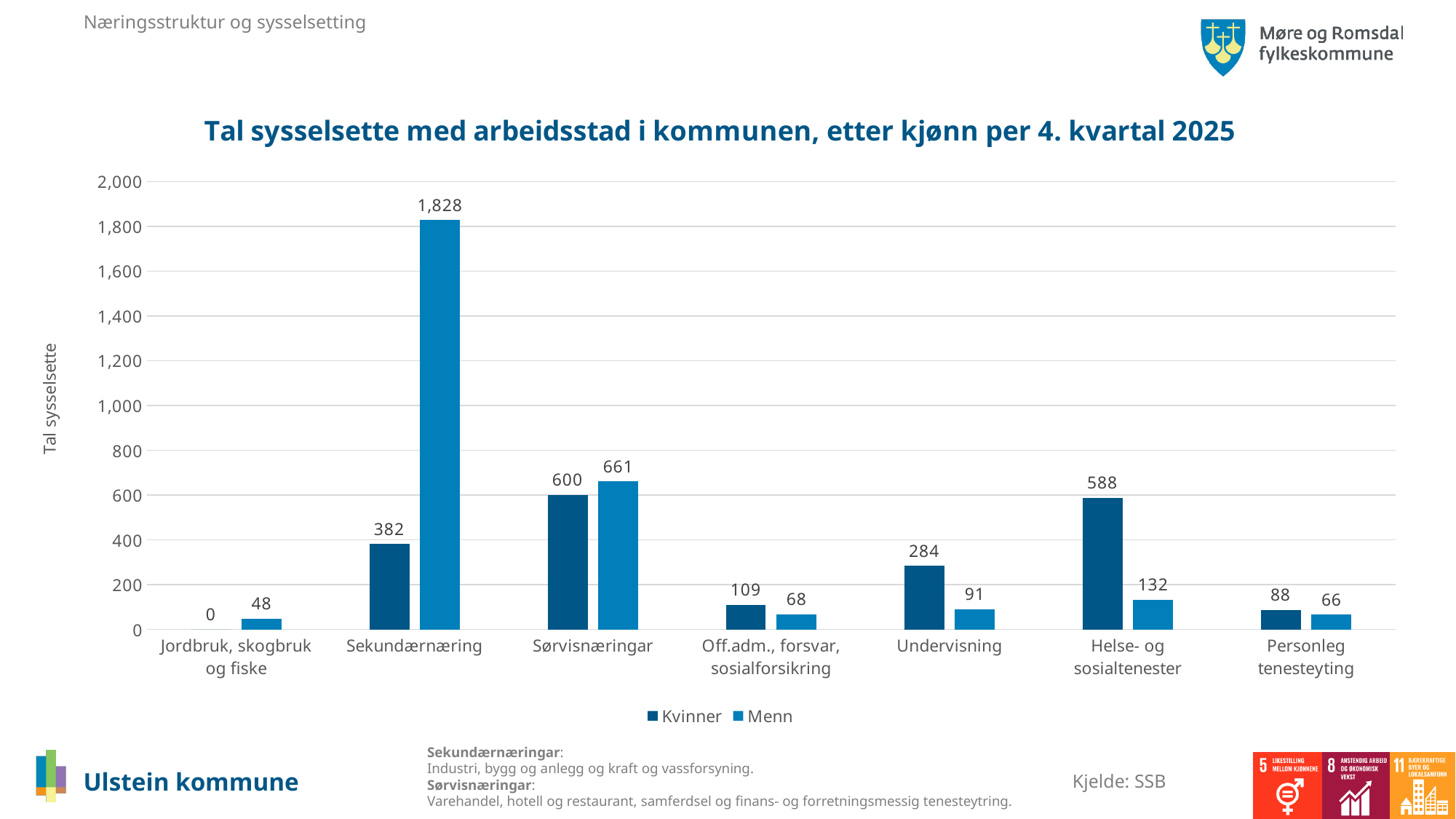
What is the value for Kvinner in Helse- og sosialtenester? 588 How many series does the legend list? 2 What is the difference between Menn and Kvinner in Sekundærnæring? 1,446 What is the total of Kvinner and Menn in Personleg tenesteyting? 154 Which category has the highest value for Kvinner? Sørvisnæringar Is the value for Menn in Sørvisnæringar greater or less than 600? greater Which category has the lowest value for Menn? Jordbruk, skogbruk og fiske What is the value for Menn in Sekundærnæring? 1,828 What kind of chart is shown on the slide? Bar chart Which is larger in Undervisning, Kvinner or Menn? Kvinner What is the value for Kvinner in Jordbruk, skogbruk og fiske? 0 How many categories are shown on the x axis? 7